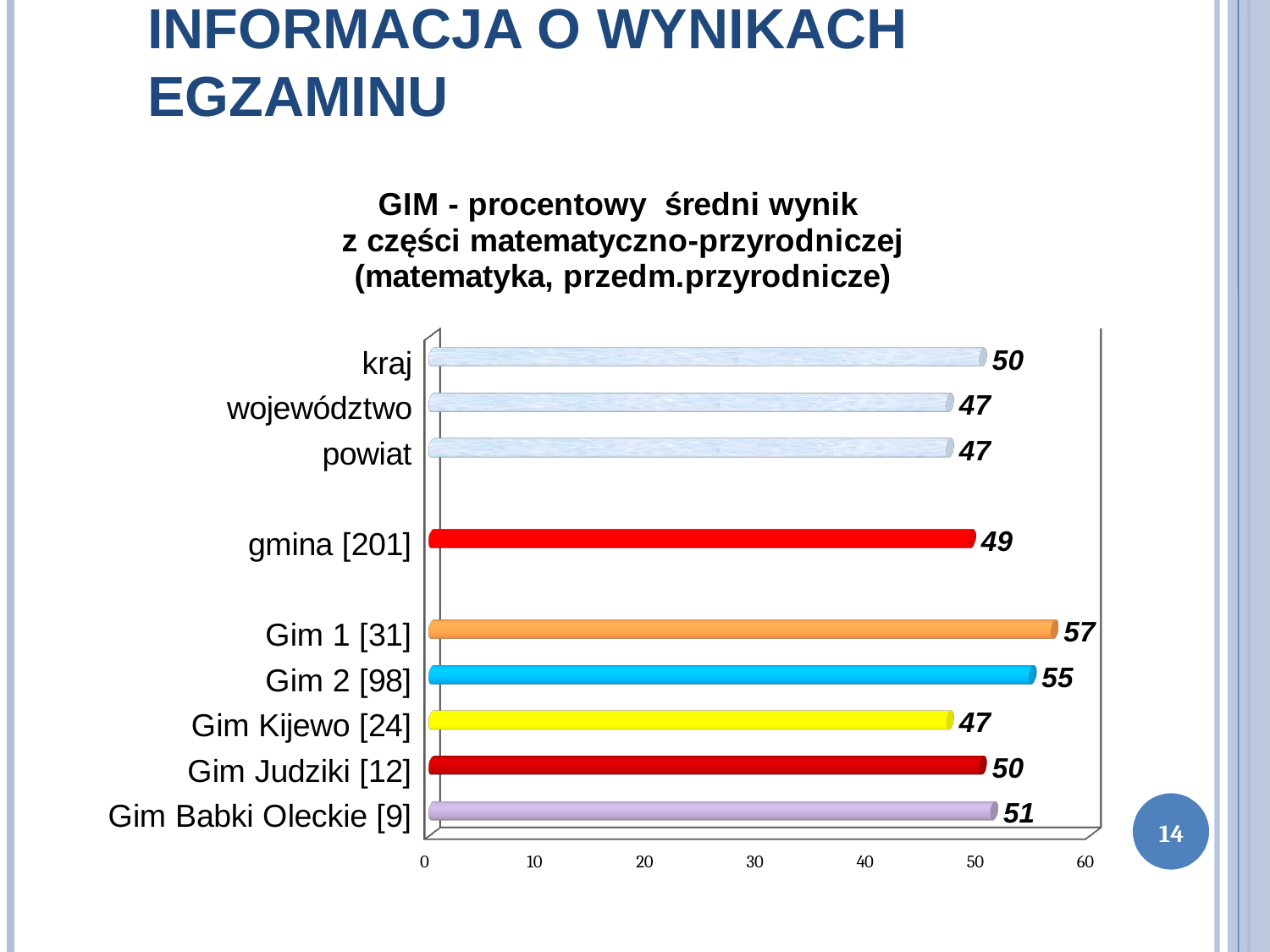
What is the value for gmina [201]? 49 What is the value for Gim 1 [31]? 57 Which is larger, the value for gmina [201] or the value for powiat? gmina [201] What is the value for kraj? 50 What is the maximum value shown on the horizontal axis? 60 What is the difference between the values for Gim 1 [31] and Gim 2 [98]? 2 How many categories are shown in the chart? 9 What is the difference between the values for Gim 2 [98] and Gim Kijewo [24]? 8 Which is larger, the value for Gim Judziki [12] or the value for Gim Kijewo [24]? Gim Judziki [12] What kind of chart is shown on the slide? bar chart Which category has the highest value? Gim 1 [31] What is the value for Gim Babki Oleckie [9]? 51